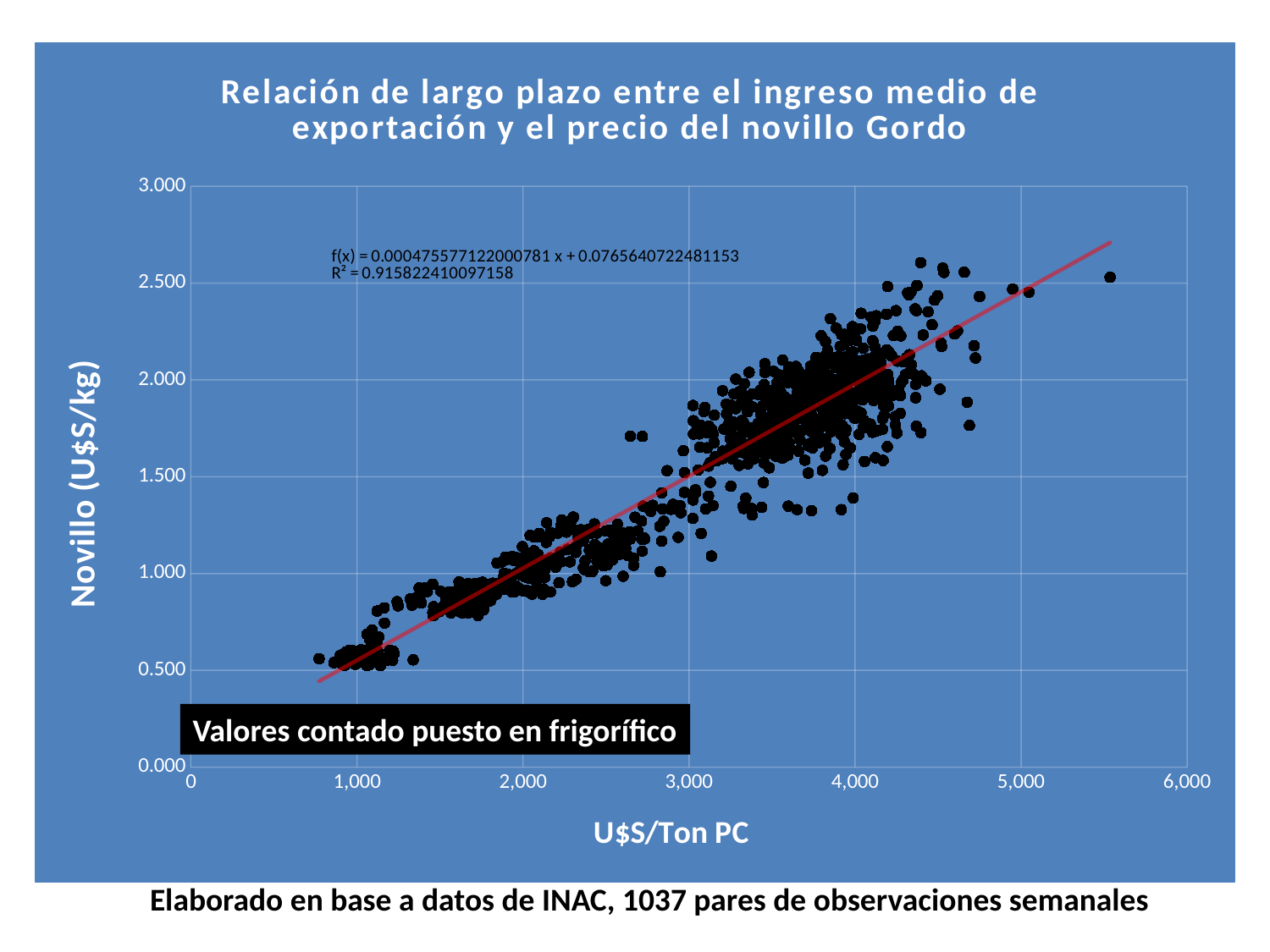
What is the slope coefficient in the fitted equation f(x) printed on the chart? 0.000475577122000781 What kind of chart is shown on the slide? Scatter chart What is the highest tick value shown on the x axis? 6,000 How many pairs of weekly observations does the slide say the chart is based on? 1037 Are the Novillo (U$S/kg) values of the points near 1,000 U$S/Ton PC greater or less than 1.000? less What R² value is printed on the chart for the fitted line? 0.915822410097158 Is the Novillo (U$S/kg) value of the point with the largest U$S/Ton PC value (around 5,500) greater or less than 2.000? greater As the value on the x axis (U$S/Ton PC) increases, do the Novillo (U$S/kg) values generally rise or fall? Rise What is the intercept in the fitted equation f(x) printed on the chart? 0.0765640722481153 What is the label of the x axis? U$S/Ton PC What is the highest tick value shown on the y axis? 3.000 What is the title of the chart? Relación de largo plazo entre el ingreso medio de exportación y el precio del novillo Gordo